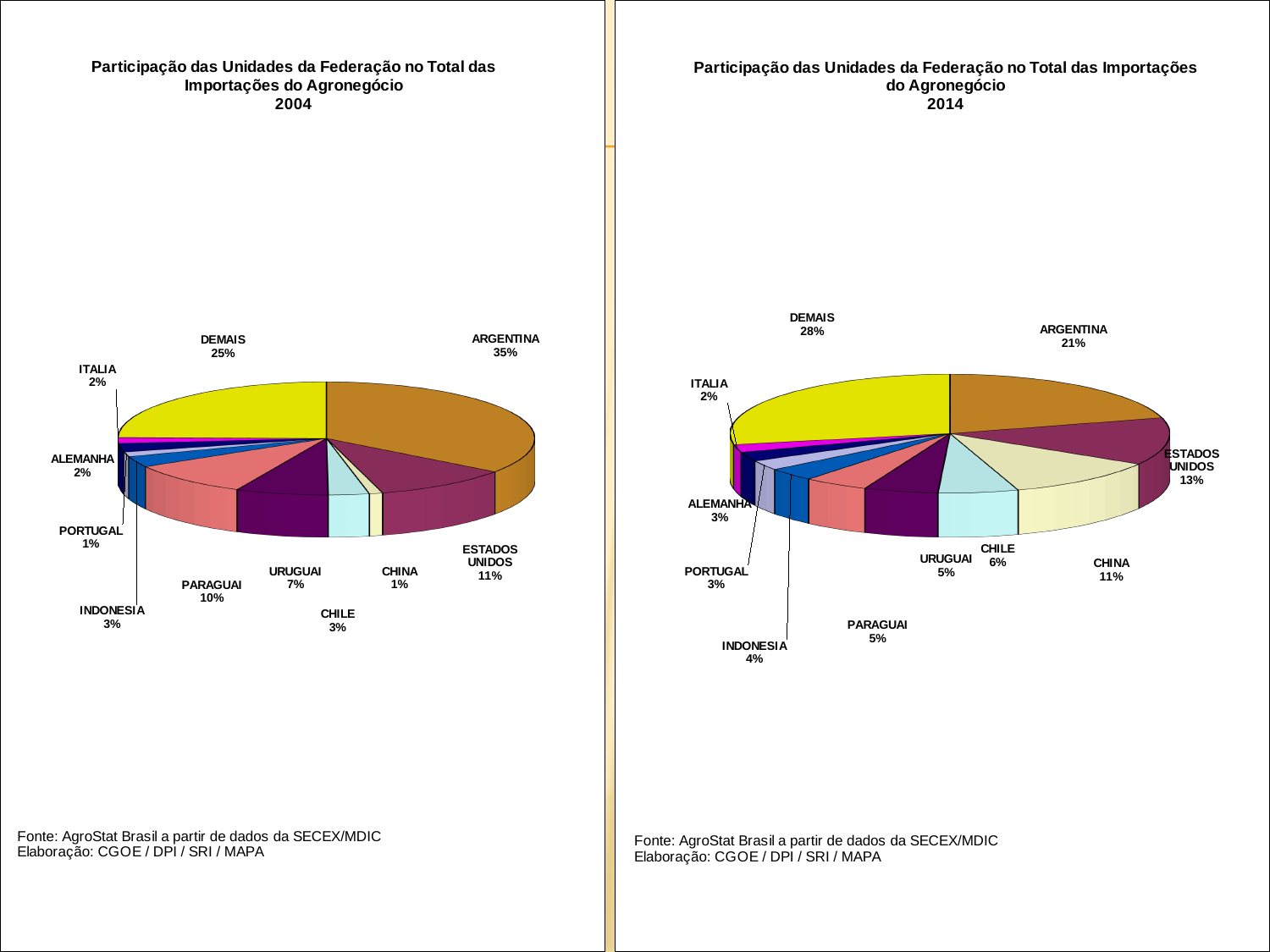
In the 2014 pie chart, which category has the largest share? DEMAIS In the 2004 pie chart, what share does PORTUGAL have? 1% What year does the right-hand pie chart cover? 2014 How many slices are labelled in the 2004 pie chart? 11 In the 2014 pie chart, what share does PARAGUAI have? 5% In the 2004 pie chart, which category has the largest share? ARGENTINA What kind of chart is shown on the left side of the slide? Pie chart In the 2014 pie chart, which is larger, the share of CHINA or the share of CHILE? CHINA In the 2004 pie chart, what share does ARGENTINA have? 35% In the 2014 pie chart, what share does ESTADOS UNIDOS have? 13% In the 2004 pie chart, what is the difference between the shares of ARGENTINA and DEMAIS? 10% In the 2014 pie chart, what is the difference between the shares of ARGENTINA and CHINA? 10%